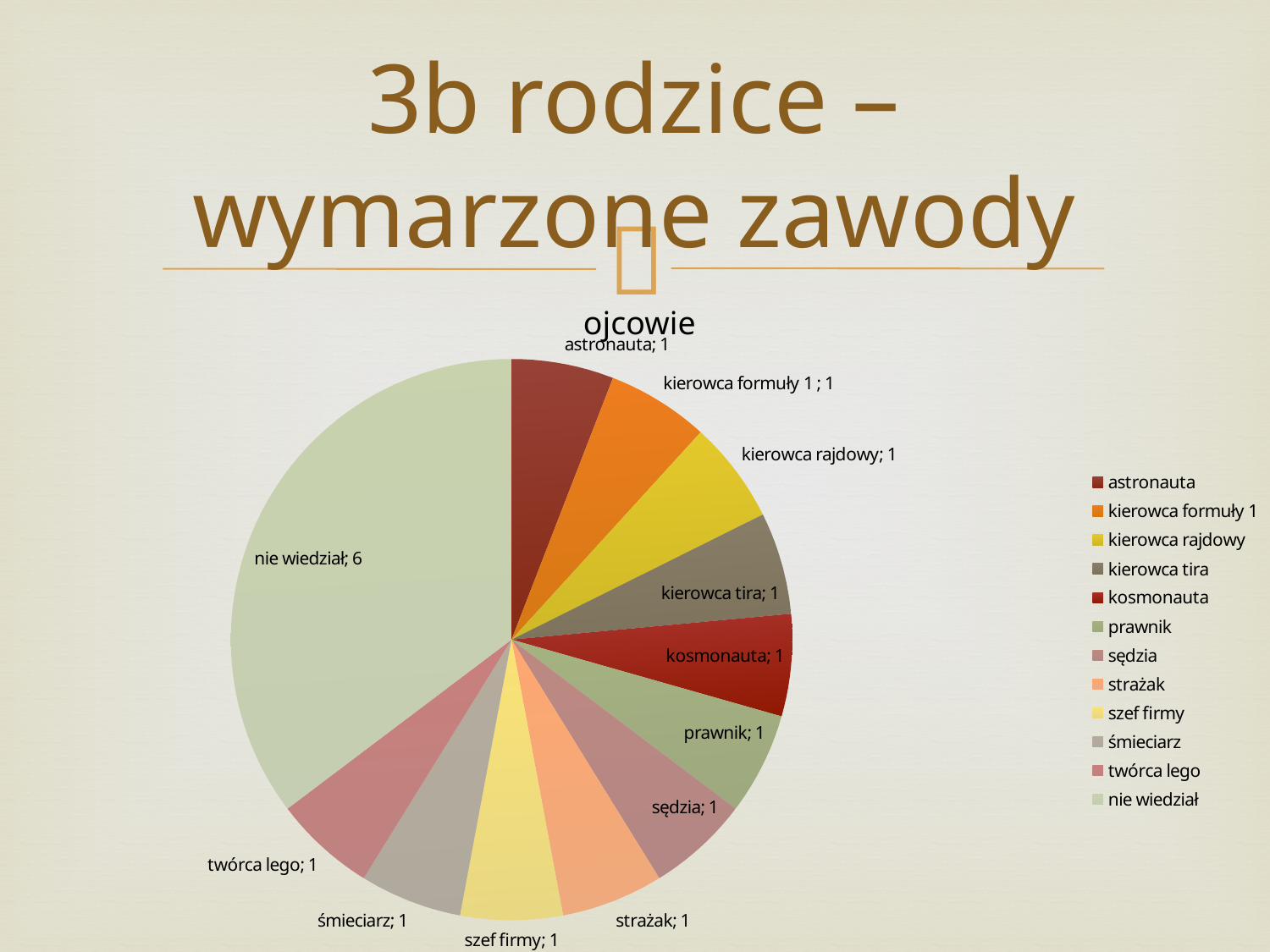
What is the title of the chart? ojcowie What is the value for 'twórca lego'? 1 Which category has the largest slice? nie wiedział What kind of chart is shown on the slide? pie chart What is the value for 'nie wiedział'? 6 What share of the total does 'nie wiedział' represent? 6 out of 17 What is the difference between the value for 'nie wiedział' and the value for 'strażak'? 5 How many entries does the legend list? 12 Which is larger, the value for 'nie wiedział' or the value for 'prawnik'? nie wiedział What is the value for 'kierowca tira'? 1 How many categories does the pie chart have? 12 What is the total of all the values in the pie chart? 17